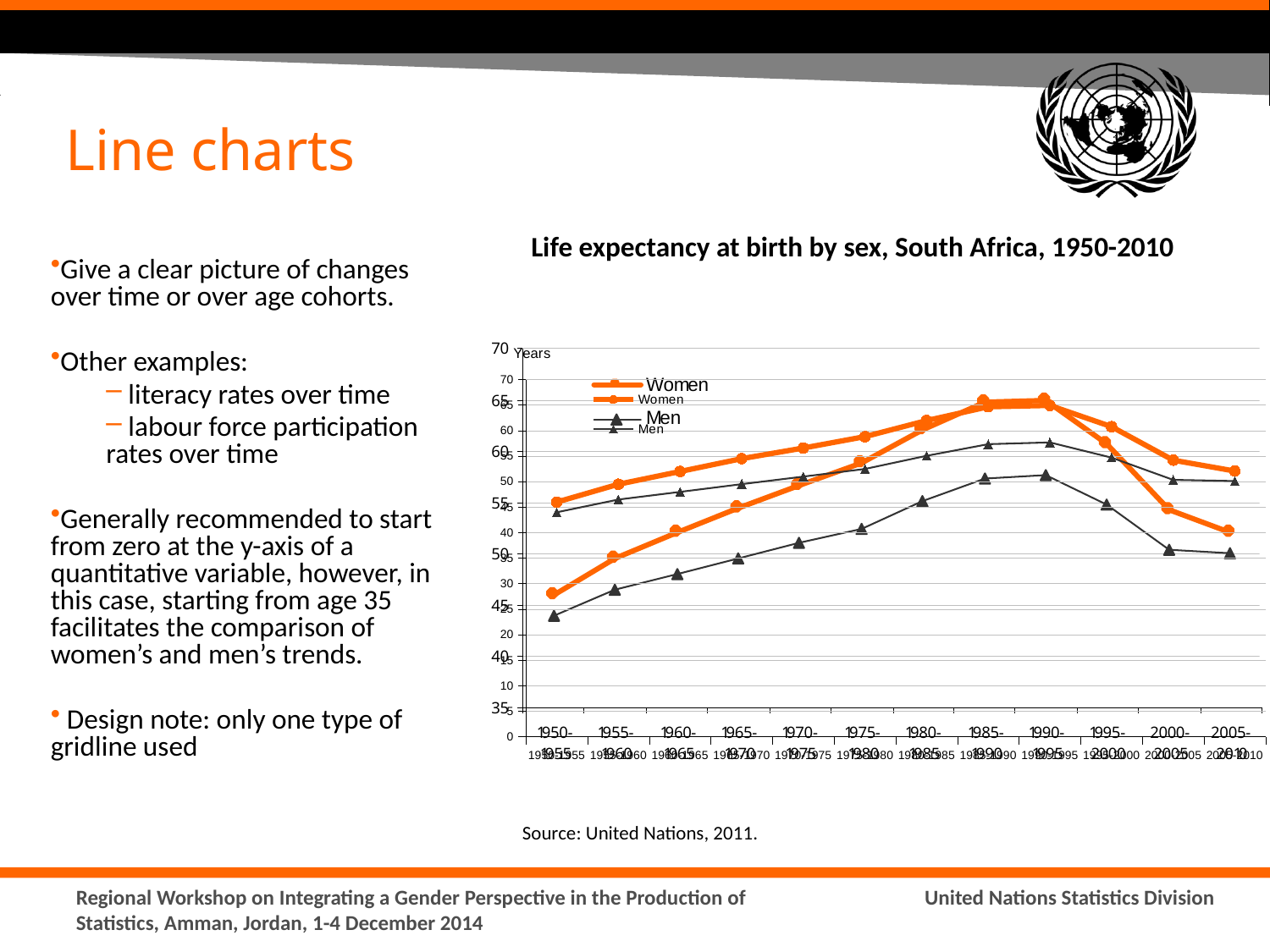
Which two series are shown in the legend of the life expectancy chart? Women and Men In the life expectancy chart, in which period is the value for Women lowest? 1950-1955 In the life expectancy chart, do the values for Women rise or fall between 1950-1955 and 1985-1990? rise In the life expectancy chart, do the values for Men rise or fall between 1990-1995 and 2005-2010? fall How many series does the legend of the life expectancy chart list? 2 How many five-year periods are plotted along the x axis of the life expectancy chart? 12 What is the title of the chart on the slide? Life expectancy at birth by sex, South Africa, 1950-2010 What type of chart is used to show life expectancy at birth by sex in South Africa? line chart In the life expectancy chart, in which period is the value for Men lowest? 1950-1955 In the life expectancy chart, which series has the higher value in 1950-1955, Women or Men? Women In the life expectancy chart, which series has the higher value in 2005-2010, Women or Men? Women What is the source cited below the life expectancy chart? United Nations, 2011